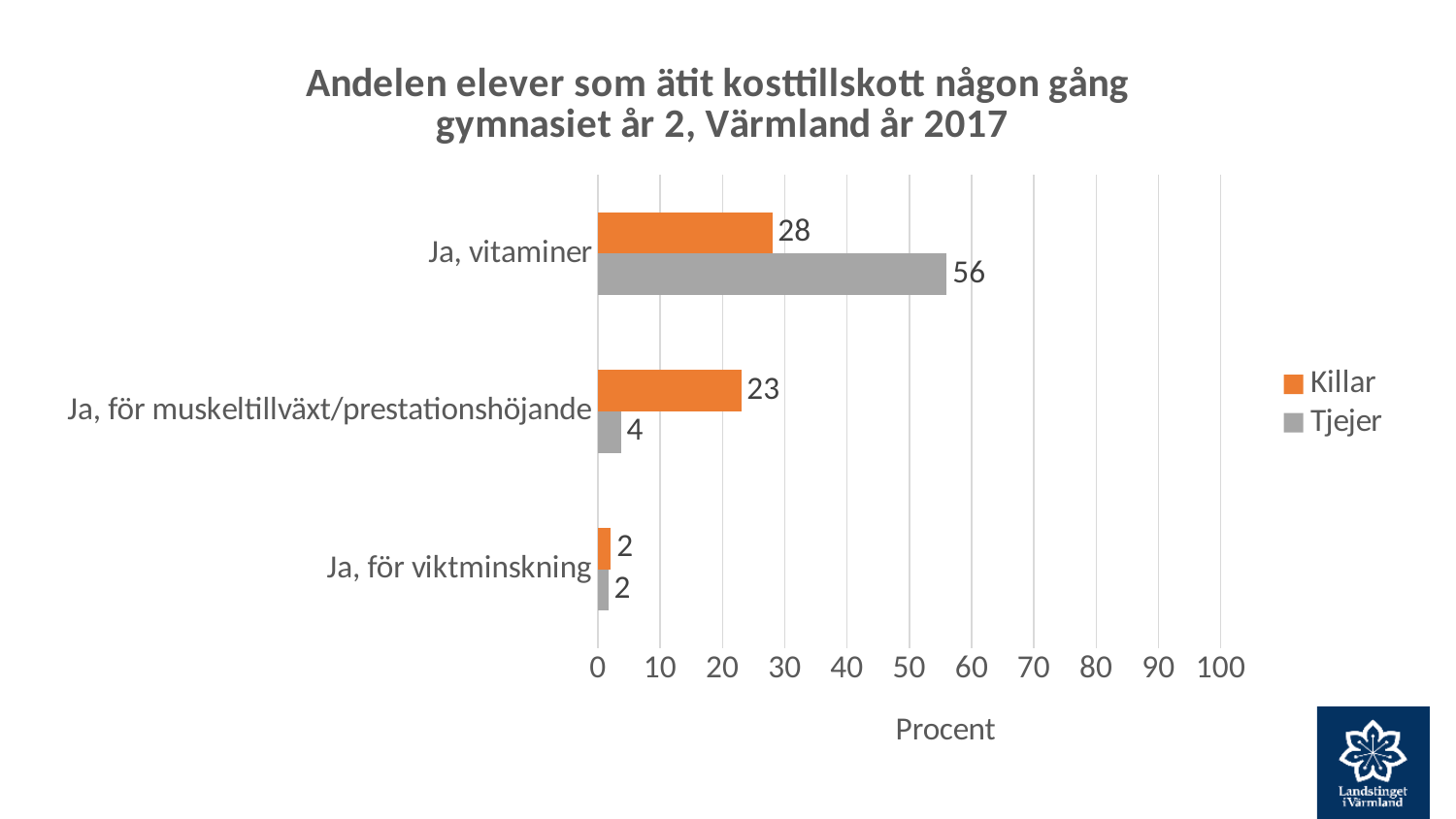
What is the value for Tjejer in the 'Ja, för viktminskning' category? 2 What is the difference between the Tjejer and Killar values for 'Ja, vitaminer'? 28 Which category has the highest value for Tjejer? Ja, vitaminer How many series does the legend list? 2 What is the label of the horizontal axis? Procent What is the value for Tjejer in the 'Ja, vitaminer' category? 56 What kind of chart is shown on the slide? Bar chart What is the value for Killar in the 'Ja, vitaminer' category? 28 How many categories are shown on the chart? 3 Which series has the larger value for 'Ja, för muskeltillväxt/prestationshöjande', Killar or Tjejer? Killar Which category has the lowest value for Killar? Ja, för viktminskning What is the value for Killar in the 'Ja, för muskeltillväxt/prestationshöjande' category? 23